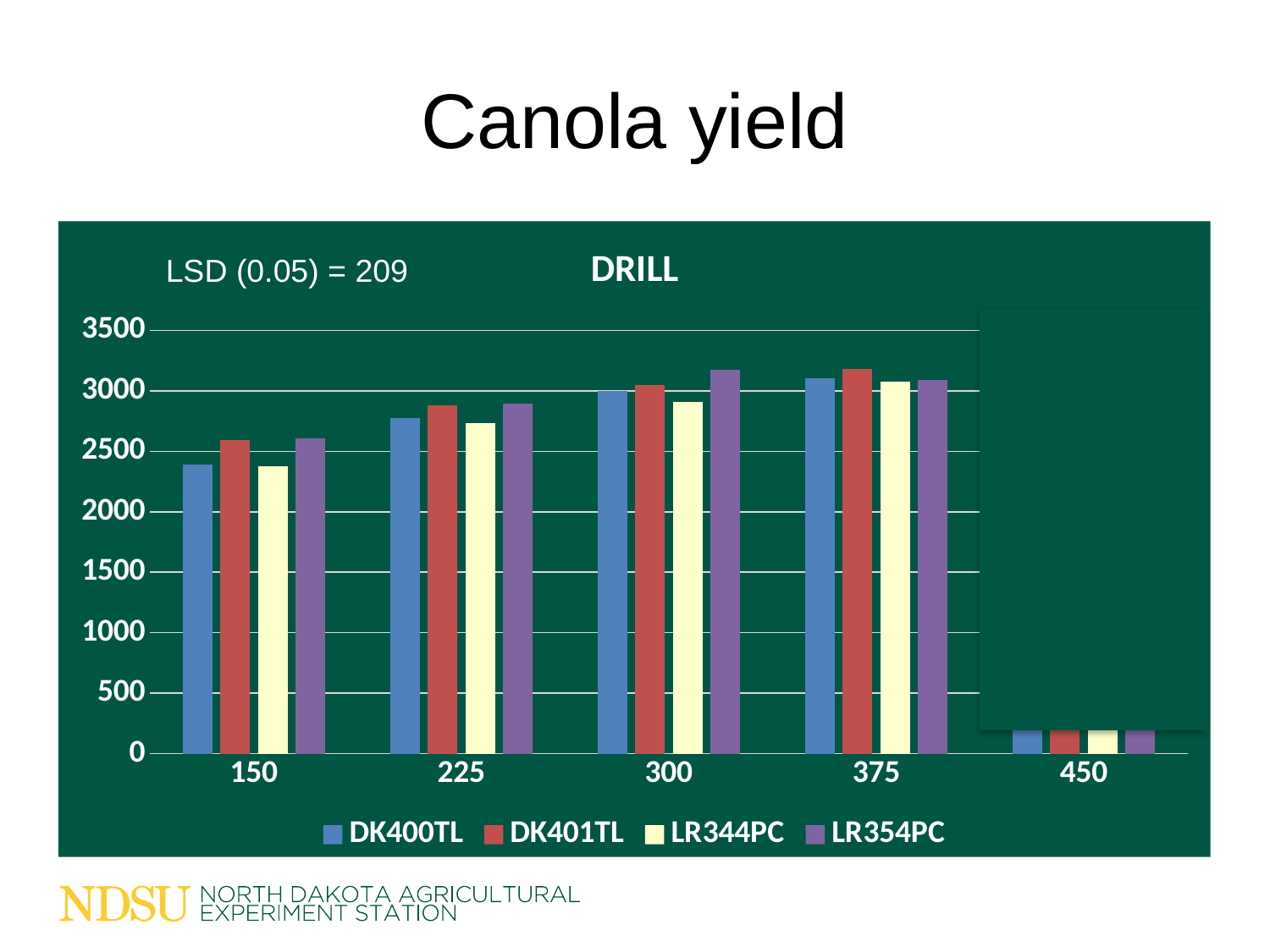
What kind of chart is shown on the slide? bar chart Do the values for DK400TL rise or fall from 150 to 375? rise Is the value for DK401TL at 150 greater or less than 2500? greater Is the value for DK400TL at 150 greater or less than 2500? less At 150, which is larger, DK401TL or DK400TL? DK401TL Which series has the highest value at 300? LR354PC How many series does the legend list? 4 Is the value for LR354PC at 300 greater or less than 3000? greater What is the title of the chart? DRILL How many categories are shown on the x axis? 5 What LSD (0.05) value is printed on the chart? 209